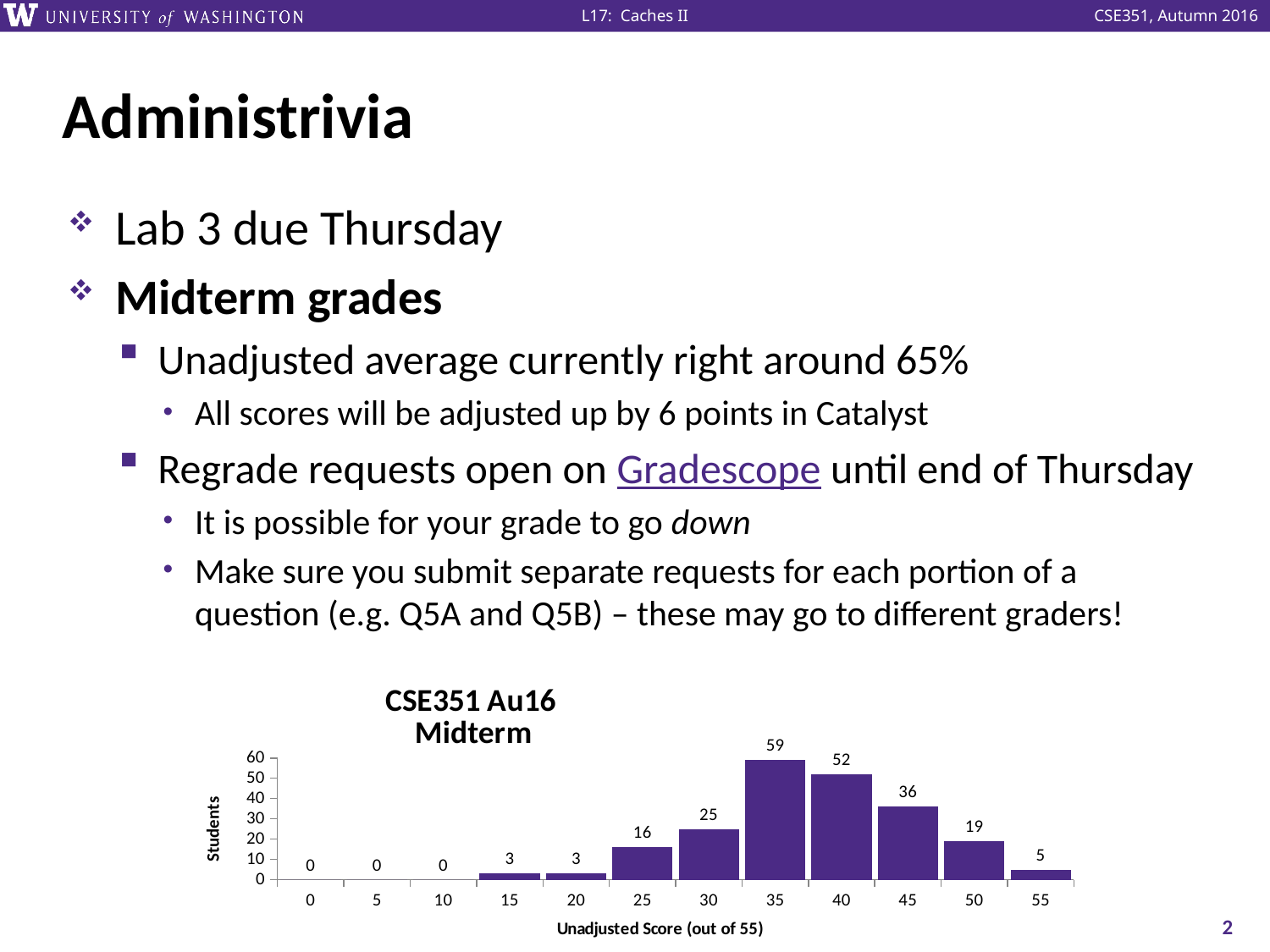
What kind of chart is shown on the slide? bar chart What is the difference in students between the 45 bin and the 50 bin? 17 Is the value for the 40 bin greater or less than 50? greater Which score bin has the highest number of students? 35 How many students scored in the 35 bin on the midterm chart? 59 What is the label of the x axis? Unadjusted Score (out of 55) What is the value shown for the score bin 25? 16 Which has more students, the 30 bin or the 45 bin? 45 What is the difference in students between the 35 bin and the 40 bin? 7 What is the value shown for the score bin 45? 36 How many score bins are shown on the x axis? 12 What is the title of the chart? CSE351 Au16 Midterm